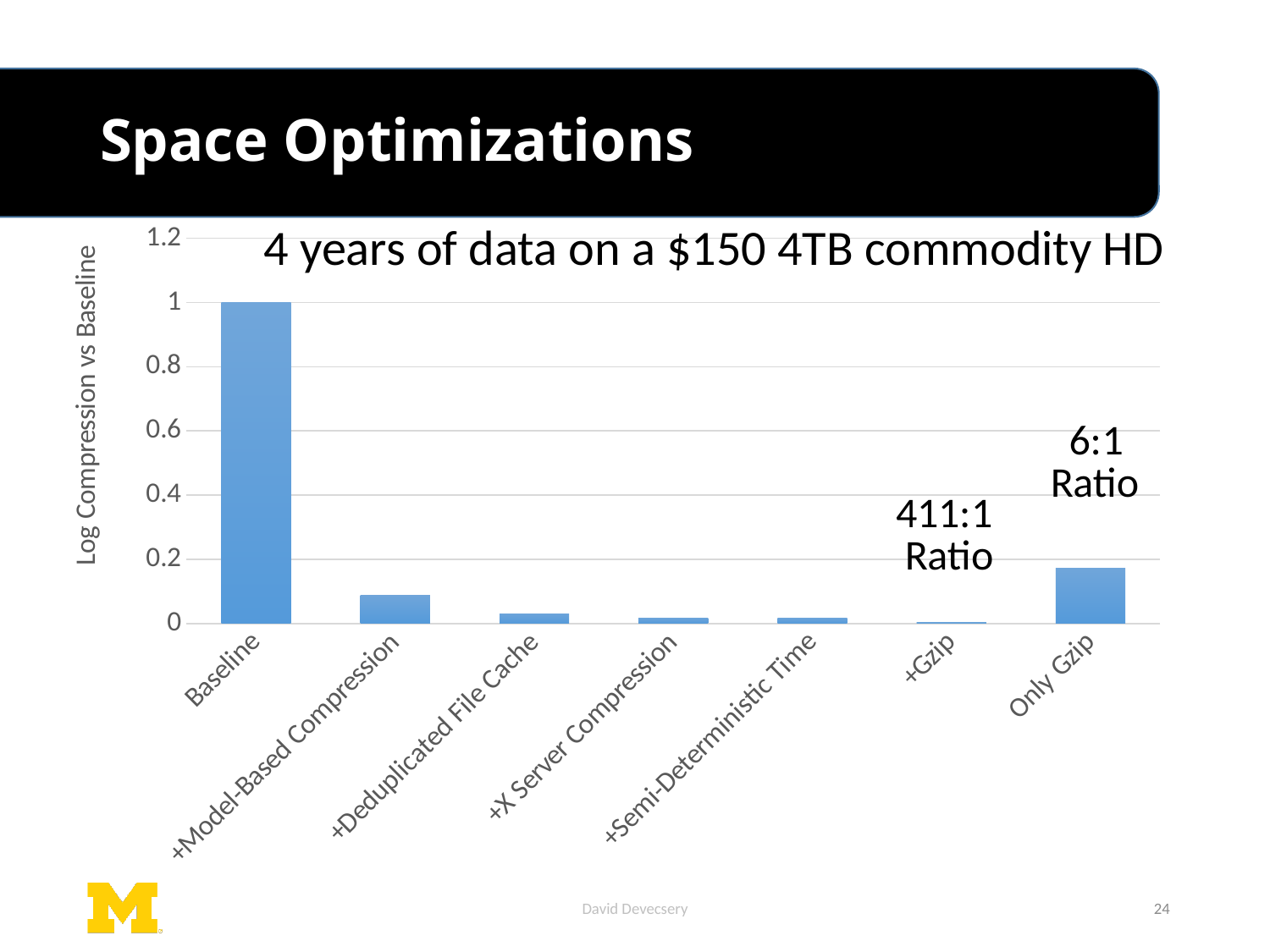
Is the value for +Model-Based Compression greater or less than 0.2? less Which category has the highest value? Baseline Is the value for Only Gzip greater or less than 0.2? less Which is larger, the value for Only Gzip or the value for +Gzip? Only Gzip Is the value for Baseline greater or less than 0.8? greater What is the value for Baseline? 1 What compression ratio is annotated next to the +Gzip bar? 411:1 Ratio What kind of chart is shown on the slide? bar chart How many categories are plotted on the x axis? 7 Which is larger, the value for +Model-Based Compression or the value for +Deduplicated File Cache? +Model-Based Compression From Baseline through +Gzip, do the values rise or fall along the x axis? fall Which category has the lowest value? +Gzip